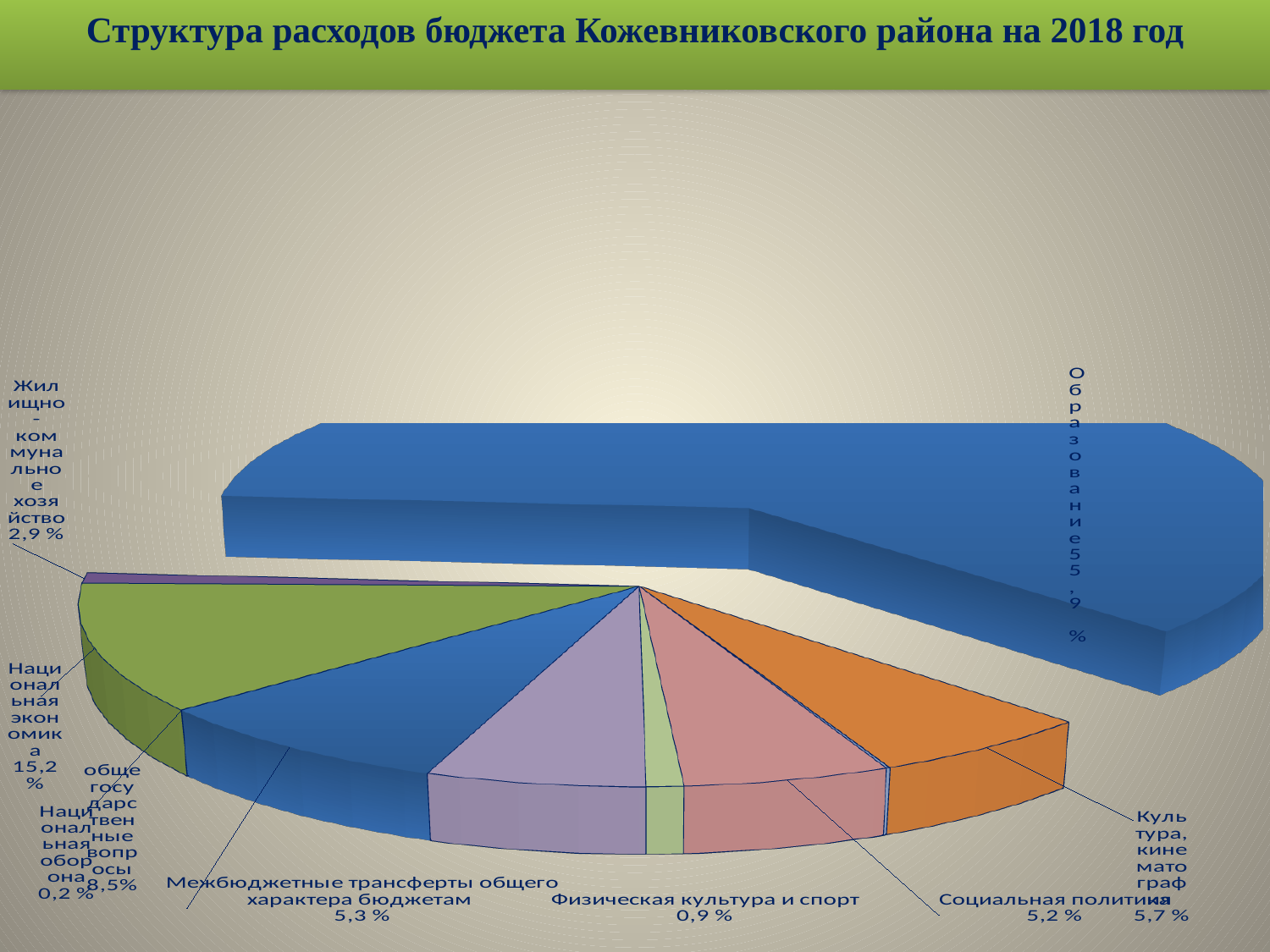
What is the difference in percentage points between Национальная экономика and Общегосударственные вопросы? 6,7 What kind of chart is shown on the slide? pie chart What share of the budget expenditures goes to Социальная политика? 5,2 % Which has a larger share: Культура, кинематография or Межбюджетные трансферты общего характера бюджетам? Культура, кинематография What share of the budget expenditures goes to Национальная экономика? 15,2 % Which has a larger share: Жилищно-коммунальное хозяйство or Общегосударственные вопросы? Общегосударственные вопросы Which category has the largest share of the budget expenditures? Образование What share of the budget expenditures goes to Образование? 55,9 % Which category has the smallest share of the budget expenditures? Национальная оборона What share of the budget expenditures goes to Физическая культура и спорт? 0,9 % What is the title of the chart on the slide? Структура расходов бюджета Кожевниковского района на 2018 год